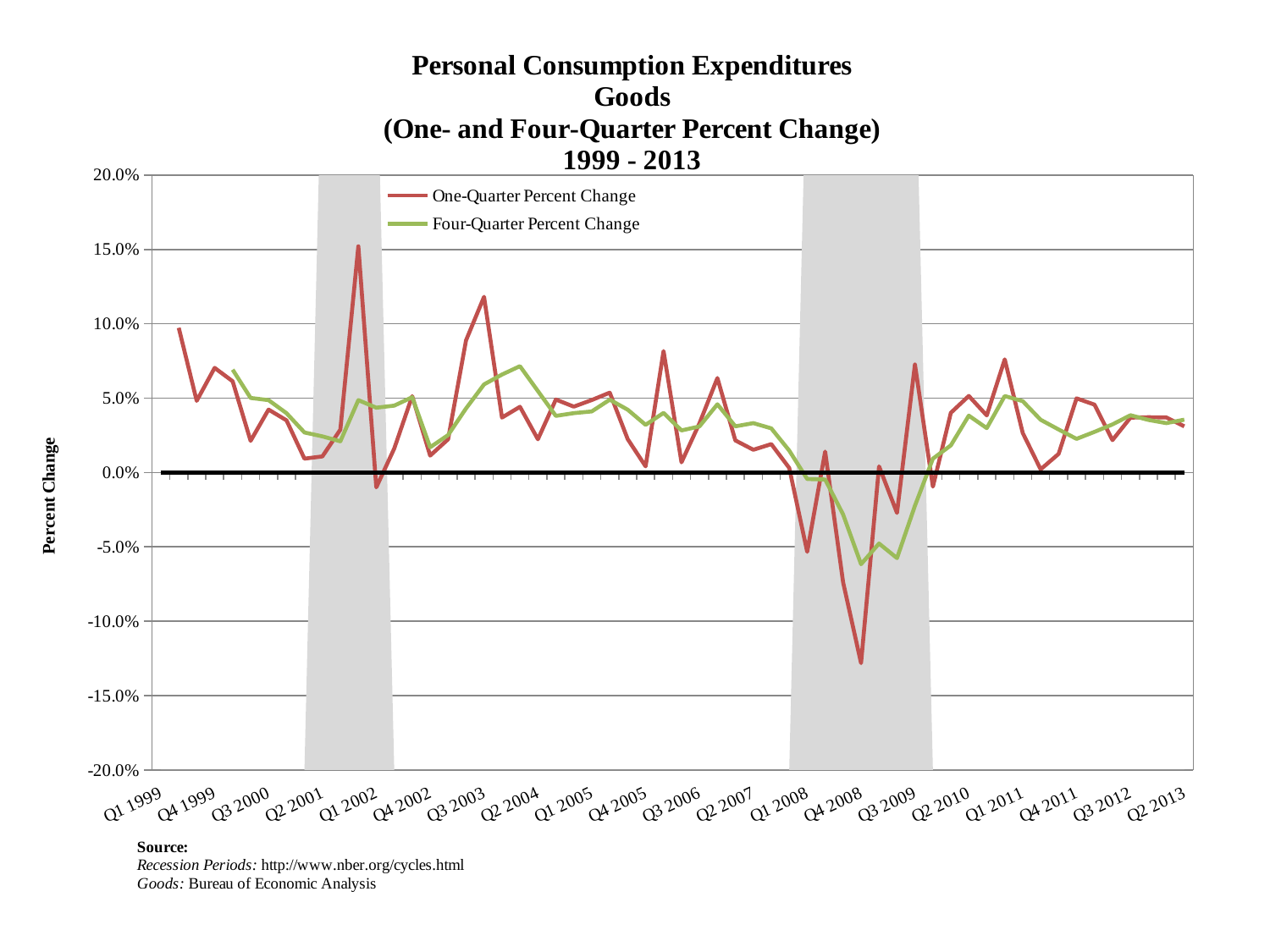
Around which x-axis label does the One-Quarter Percent Change line reach its lowest point? Q4 2008 How many series does the legend list? 2 Is the lowest Four-Quarter Percent Change value, reached around Q4 2008, greater or less than -5.0%? less What is the label on the vertical axis? Percent Change Is the One-Quarter Percent Change value at Q3 2003 greater or less than 10.0%? greater What are the two series named in the legend? One-Quarter Percent Change; Four-Quarter Percent Change Around which x-axis label does the One-Quarter Percent Change line reach its highest point? Q1 2002 Which series reaches a higher peak value over the whole period, One-Quarter Percent Change or Four-Quarter Percent Change? One-Quarter Percent Change Is the lowest One-Quarter Percent Change value near Q4 2008 greater or less than -10.0%? less What kind of chart is shown on the slide? line chart